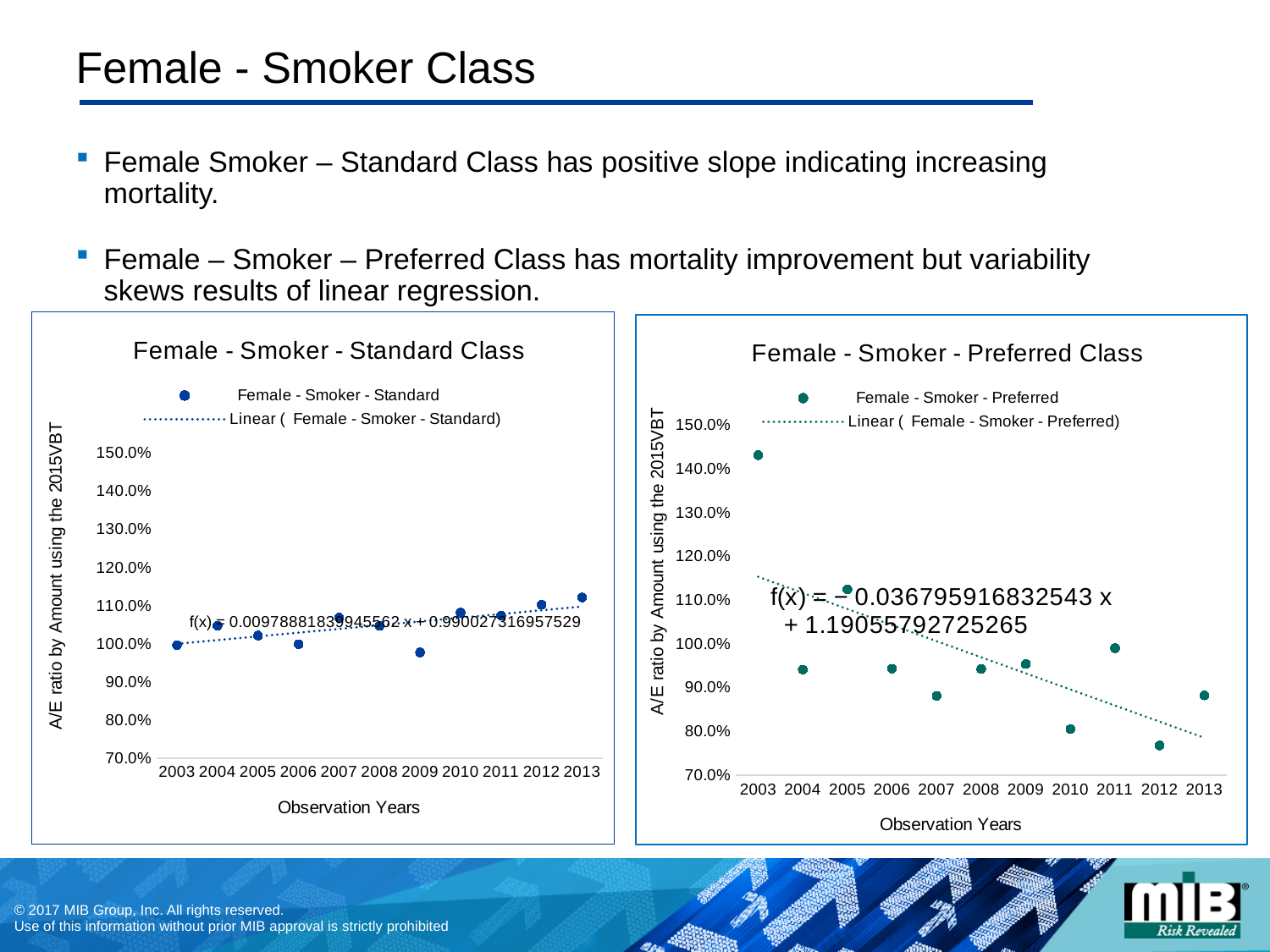
In the Female - Smoker - Preferred Class chart, which observation year has the highest A/E ratio? 2003 In the Female - Smoker - Preferred Class chart, is the value for 2003 greater or less than 130.0%? greater In the Female - Smoker - Standard Class chart, does the trend line rise or fall across the observation years? rise In the Female - Smoker - Preferred Class chart, which is larger, the value for 2003 or the value for 2013? 2003 How many entries does the legend of the Female - Smoker - Standard Class chart list? 2 In the Female - Smoker - Standard Class chart, is the value for 2003 greater or less than 110.0%? less In the Female - Smoker - Preferred Class chart, does the trend line rise or fall across the observation years? fall In the Female - Smoker - Preferred Class chart, is the value for 2012 greater or less than 80.0%? less What kind of chart is the Female - Smoker - Standard Class chart? scatter chart How many data points are plotted in the Female - Smoker - Preferred Class chart? 11 In the Female - Smoker - Preferred Class chart, which observation year has the lowest A/E ratio? 2012 What is the x-axis title of the Female - Smoker - Standard Class chart? Observation Years